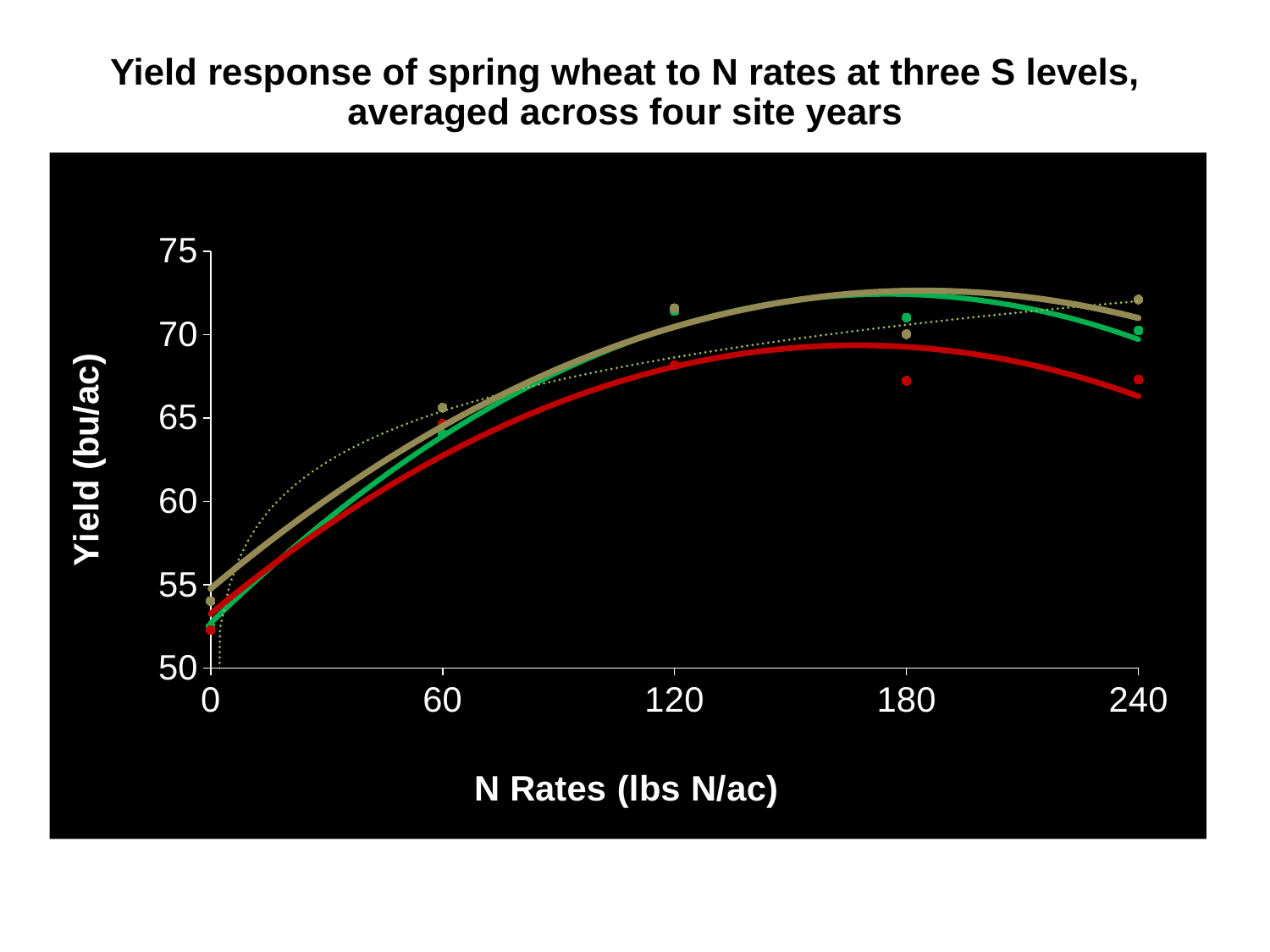
What is the label of the y axis? Yield (bu/ac) Is the yield for the tan series at an N rate of 240 greater or less than 70? greater Is the yield for the green series at an N rate of 60 greater or less than 60? greater Is the yield for the tan series at an N rate of 120 greater or less than 70? greater At an N rate of 180, is the yield for the tan series larger or smaller than the yield for the red series? larger How many N rates are plotted along the x axis? 5 What is the title of the chart? Yield response of spring wheat to N rates at three S levels, averaged across four site years What kind of chart is shown on the slide? Scatter chart with fitted curves At an N rate of 240, which series has the lowest yield: red, green or tan? red Do the yields rise or fall as the N rate increases from 0 to 120 lbs N/ac? rise